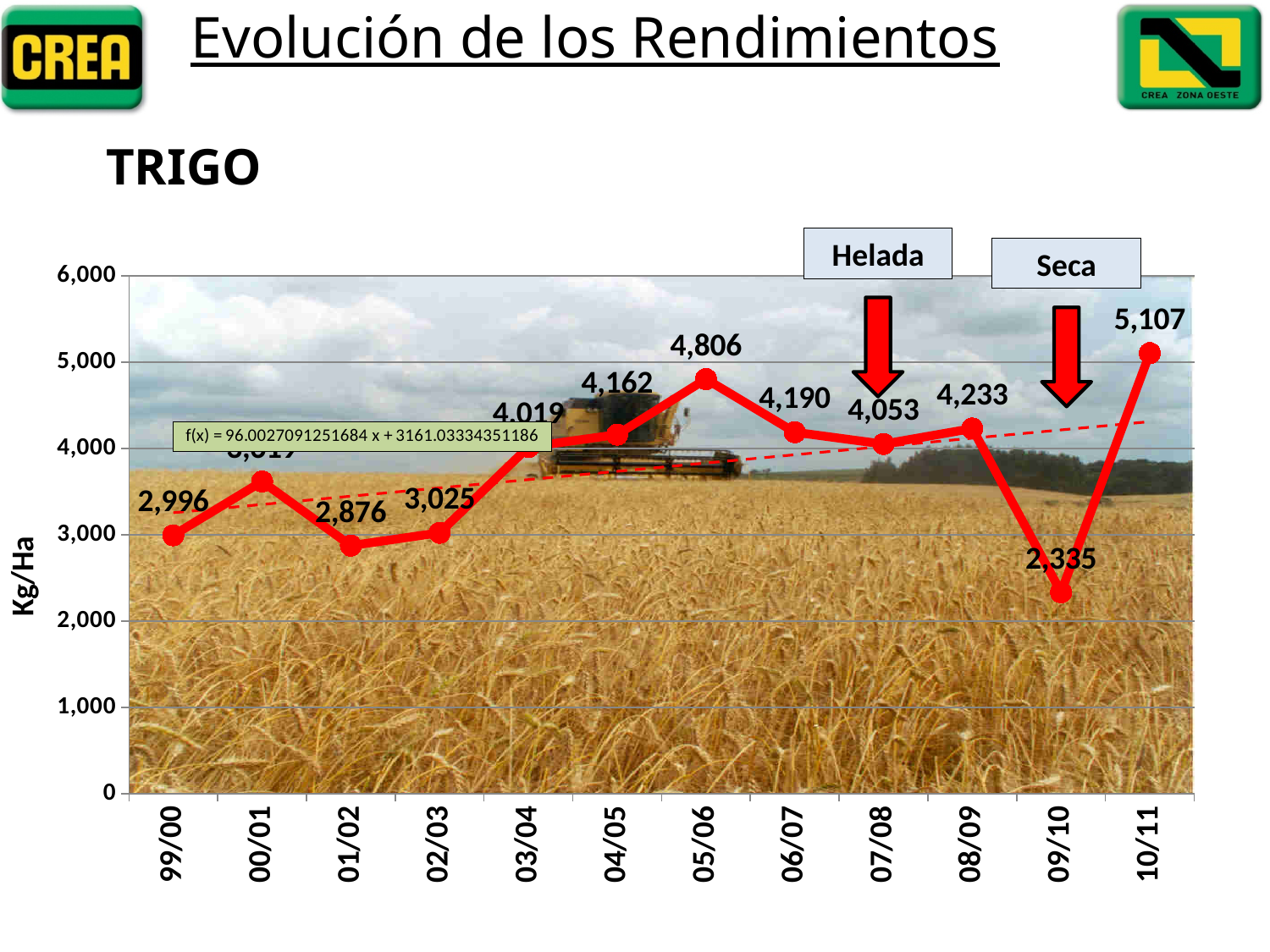
What is the yield value for 99/00? 2,996 Which season has the lowest yield? 09/10 What is the yield value for 05/06? 4,806 Which season has the highest yield? 10/11 What is the yield value for 09/10? 2,335 What kind of chart is shown on the slide? line chart How many seasons are plotted on the x axis? 12 What is the difference between the yields for 10/11 and 09/10? 2,772 What is the label on the y axis? Kg/Ha Which season has a higher yield, 05/06 or 06/07? 05/06 Is the value for 00/01 greater or less than 3,000? greater What is the yield value for 10/11? 5,107